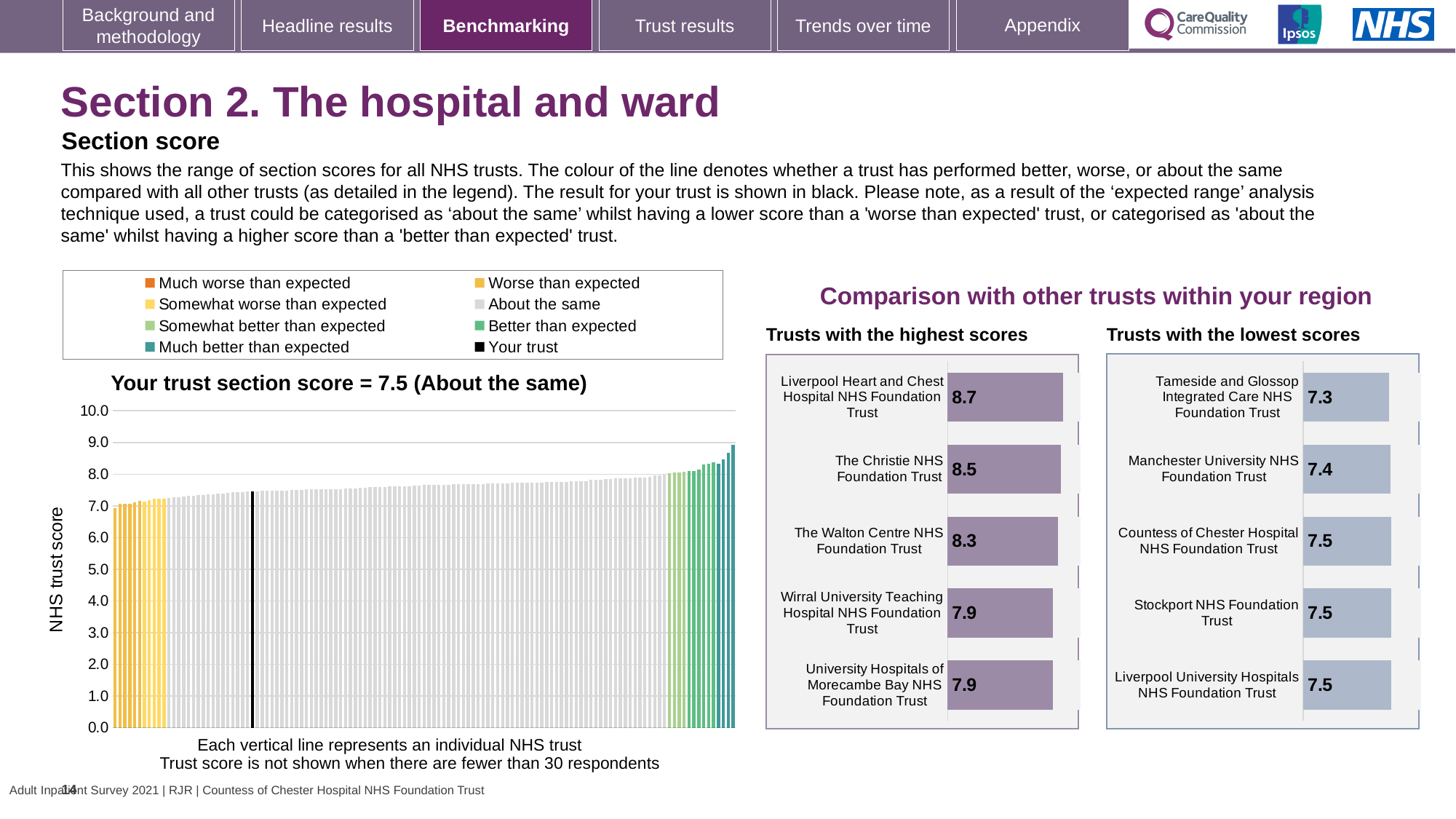
In the 'Trusts with the highest scores' chart, which has the larger score: The Walton Centre NHS Foundation Trust or Wirral University Teaching Hospital NHS Foundation Trust? The Walton Centre NHS Foundation Trust In the 'Trusts with the lowest scores' chart, what is the score for Tameside and Glossop Integrated Care NHS Foundation Trust? 7.3 How many entries does the legend above the main chart on the left list? 8 How many trusts are listed in the 'Trusts with the lowest scores' chart? 5 In the 'Trusts with the highest scores' chart, what is the score for Liverpool Heart and Chest Hospital NHS Foundation Trust? 8.7 According to the title of the main chart on the left, what is your trust's section score? 7.5 In the 'Trusts with the lowest scores' chart, what is the score for Manchester University NHS Foundation Trust? 7.4 In the 'Trusts with the lowest scores' chart, which trust has the lowest score? Tameside and Glossop Integrated Care NHS Foundation Trust In the 'Trusts with the highest scores' chart, what is the score for The Walton Centre NHS Foundation Trust? 8.3 In the main chart on the left, do the trust scores rise or fall from left to right along the x axis? rise In the 'Trusts with the highest scores' chart, which trust has the highest score? Liverpool Heart and Chest Hospital NHS Foundation Trust In the 'Trusts with the highest scores' chart, what is the difference between the scores of Liverpool Heart and Chest Hospital NHS Foundation Trust and The Christie NHS Foundation Trust? 0.2